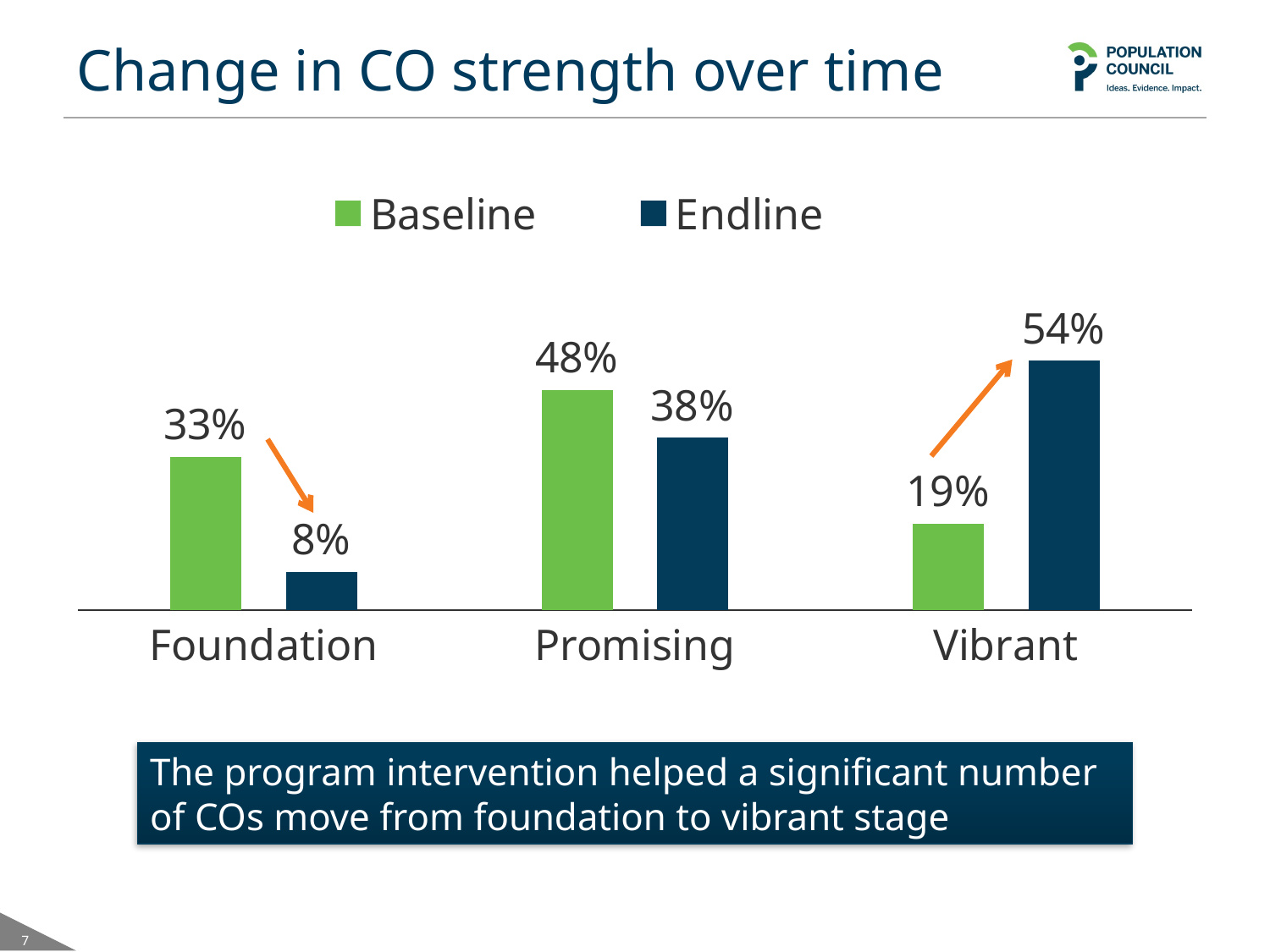
What is the Baseline value for Vibrant? 19% What is the difference between the Endline and Baseline values for Vibrant? 35% What is the Baseline value for Foundation? 33% What is the difference between the Baseline and Endline values for Foundation? 25% Which category has the highest Baseline value? Promising Which category has the lowest Endline value? Foundation How many categories are shown on the x axis? 3 How many series does the legend list? 2 What is the Endline value for Vibrant? 54% What kind of chart is shown on the slide? Bar chart Which is larger for Promising, the Baseline value or the Endline value? Baseline What is the Endline value for Promising? 38%